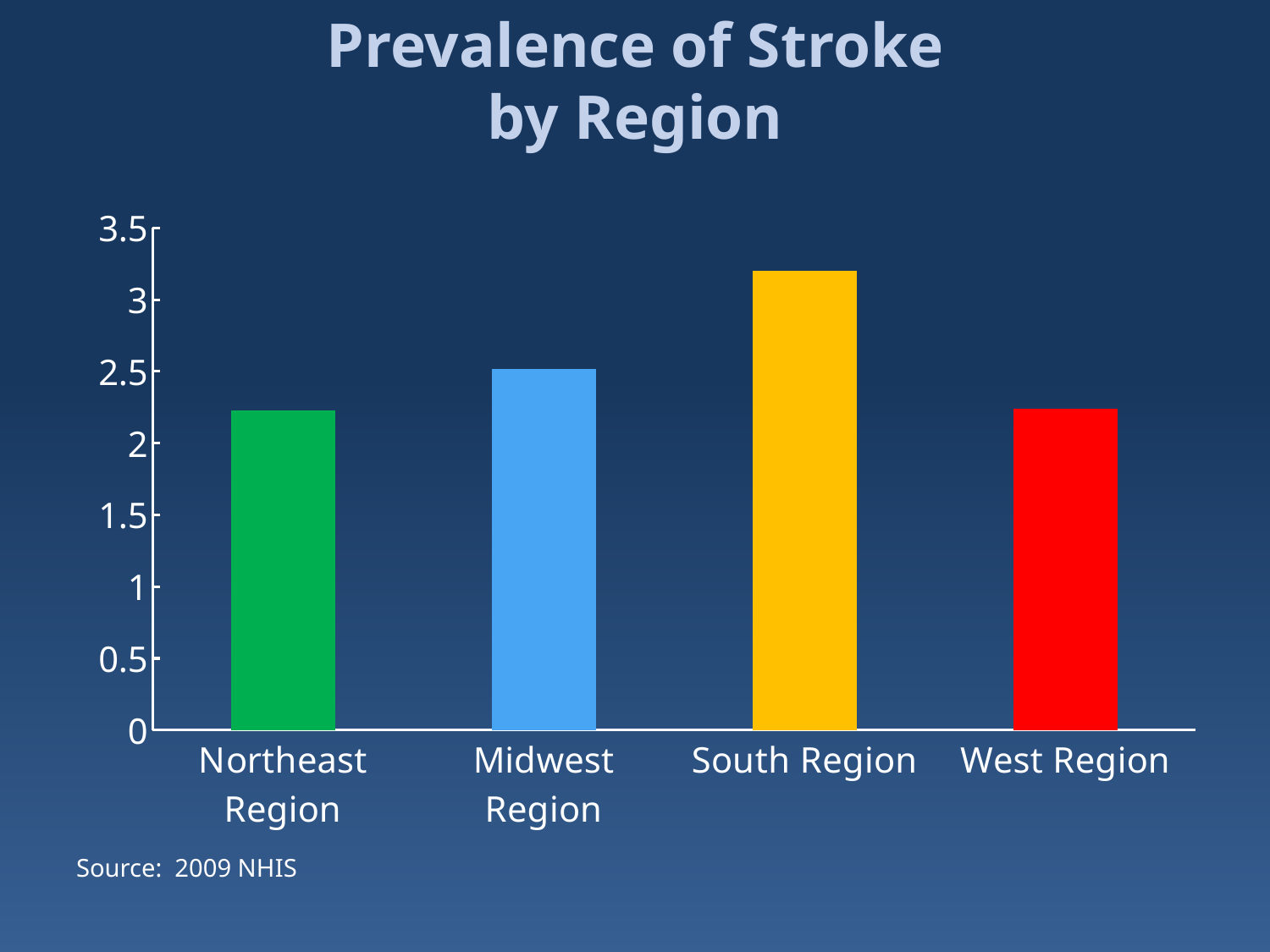
Is the value for Northeast Region greater or less than 2.5? less Is the value for South Region greater or less than 3? greater What colour is the bar for South Region? yellow How many regions are shown on the chart? 4 What type of chart is shown on the slide? bar chart What is the title of the chart? Prevalence of Stroke by Region Which is larger, the value for Midwest Region or the value for West Region? Midwest Region Is the value for Midwest Region greater or less than 3? less Which is larger, the value for South Region or the value for Midwest Region? South Region Which region has the highest prevalence of stroke? South Region